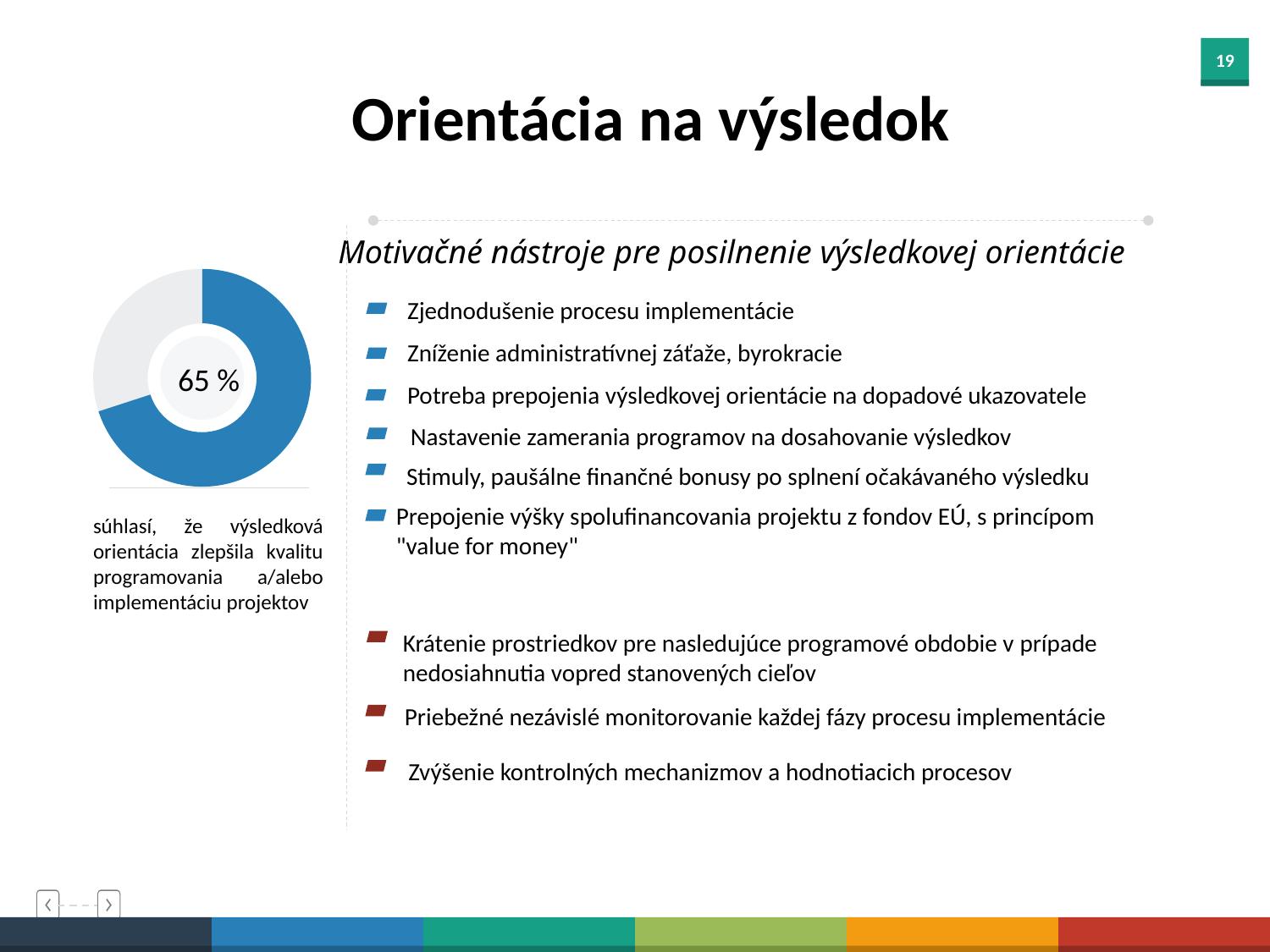
What kind of chart is shown on the left of the slide? Donut (pie) chart How many segments does the donut chart have? 2 What percentage is printed in the centre of the donut chart? 65 % Is the value shown in the donut chart greater or less than 50 %? greater Which segment of the donut chart is larger, the blue one or the grey one? The blue one What colour is the larger segment of the donut chart? Blue According to the text under the donut chart, what does the 65 % represent? Those who agree that result orientation improved the quality of programming and/or project implementation